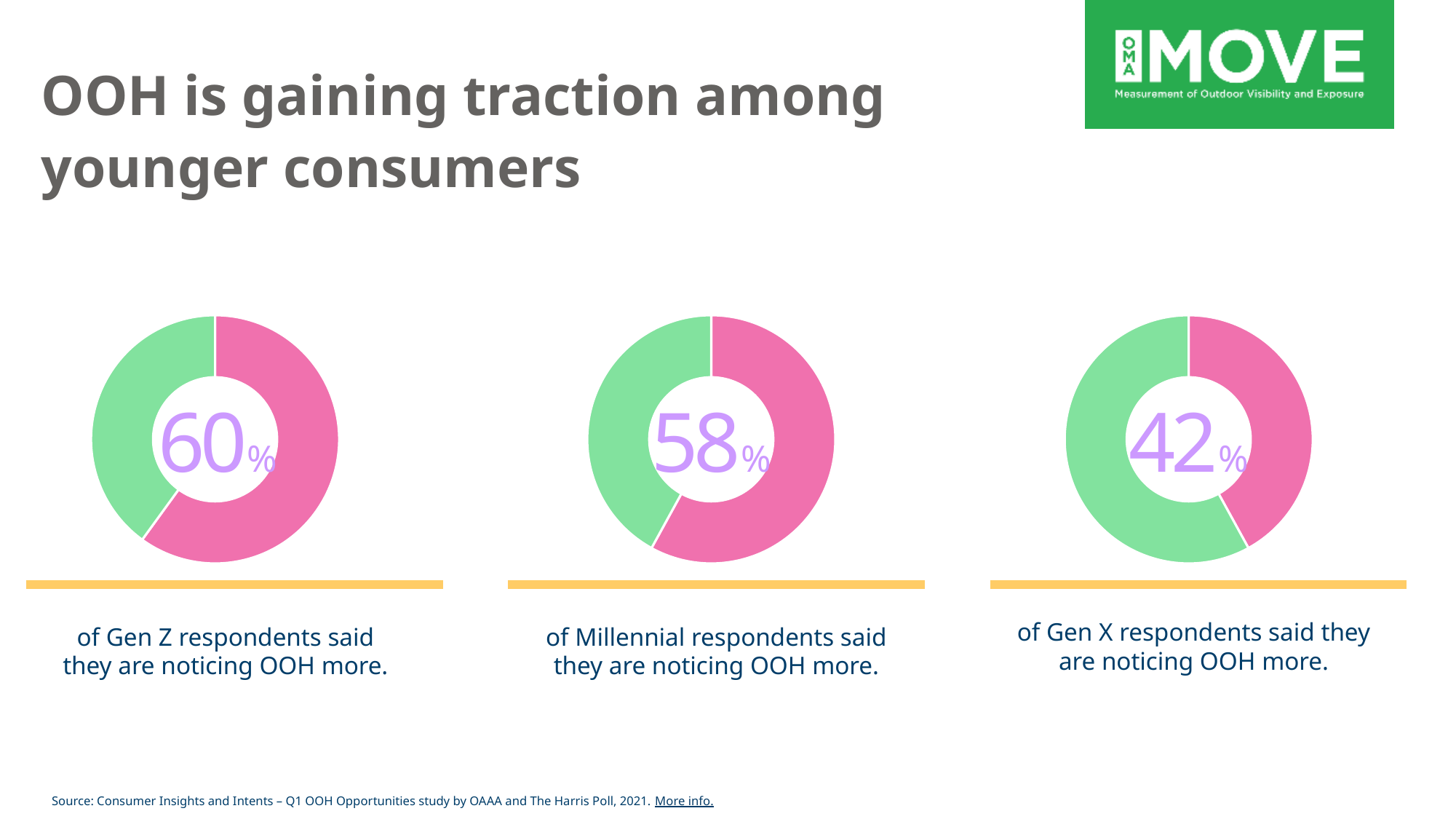
What percentage of Gen X respondents said they are noticing OOH more, according to the right donut chart? 42% What percentage of Millennial respondents said they are noticing OOH more, according to the middle donut chart? 58% What is the difference in percentage points between the Gen Z value and the Millennial value? 2 Which generation shown on the slide has the lowest share of respondents noticing OOH more? Gen X What is the difference in percentage points between the Gen Z value and the Gen X value? 18 What percentage of Gen Z respondents said they are noticing OOH more, according to the left donut chart? 60% What colour is the segment representing the stated percentage in each donut chart? Pink Is the value for Millennials larger or smaller than the value for Gen X? larger How many donut charts are shown on the slide? 3 What kind of chart is used to show each generation's value on the slide? Donut (pie) chart Which generation shown on the slide has the highest share of respondents noticing OOH more? Gen Z In the right donut chart for Gen X, what share of the ring is not pink (the remaining portion)? 58%